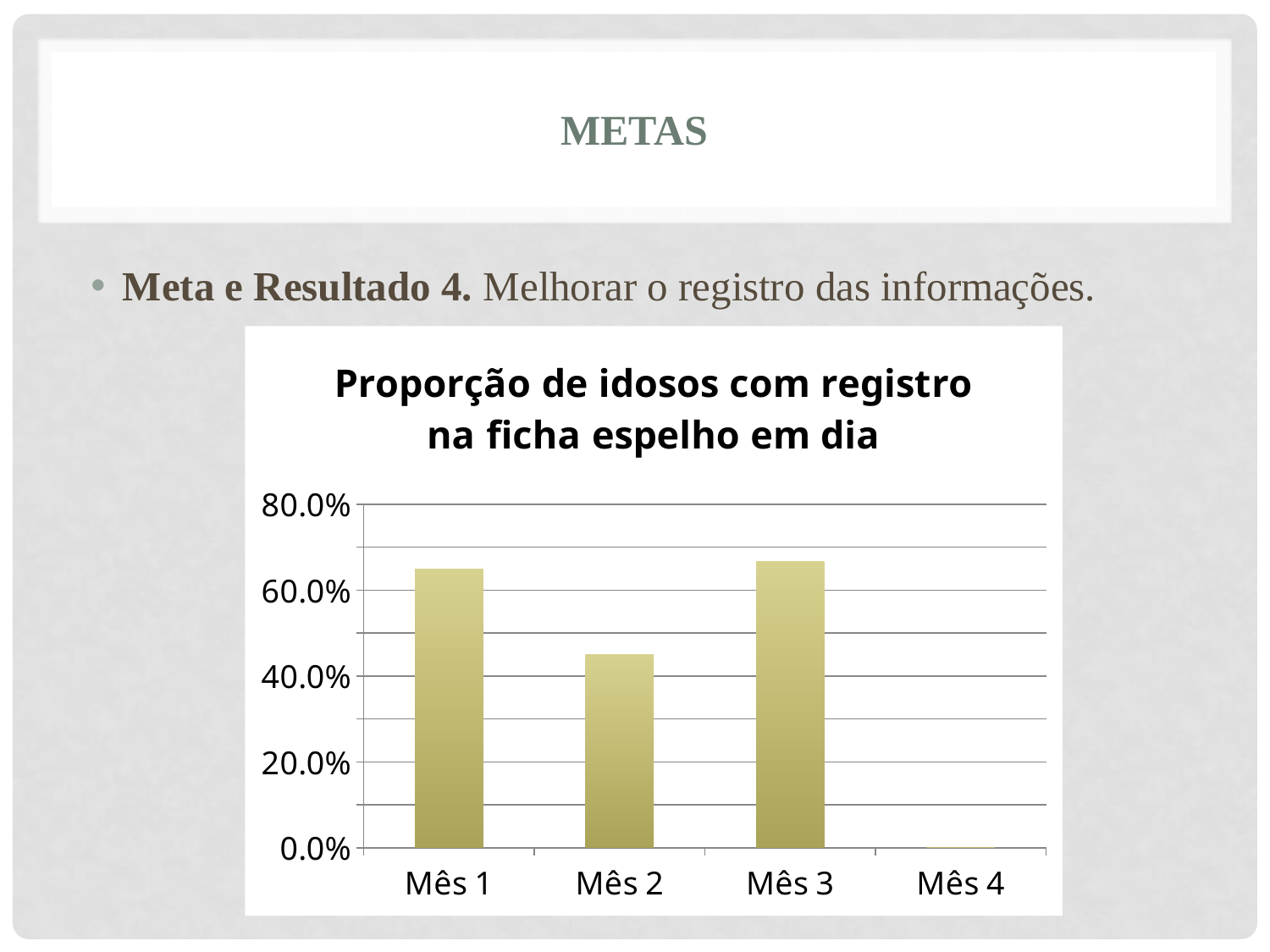
Is the value for Mês 3 greater or less than 60.0%? greater Is the value for Mês 3 greater or less than 80.0%? less Is the value for Mês 1 greater or less than 60.0%? greater Which has the larger value, Mês 2 or Mês 3? Mês 3 Which has the larger value, Mês 1 or Mês 2? Mês 1 Among Mês 1, Mês 2 and Mês 3, which month has the lowest value? Mês 2 Does the value rise or fall from Mês 1 to Mês 2? fall What is the title of the chart? Proporção de idosos com registro na ficha espelho em dia How many month categories are shown on the x axis of the chart? 4 What kind of chart is shown on the slide? bar chart